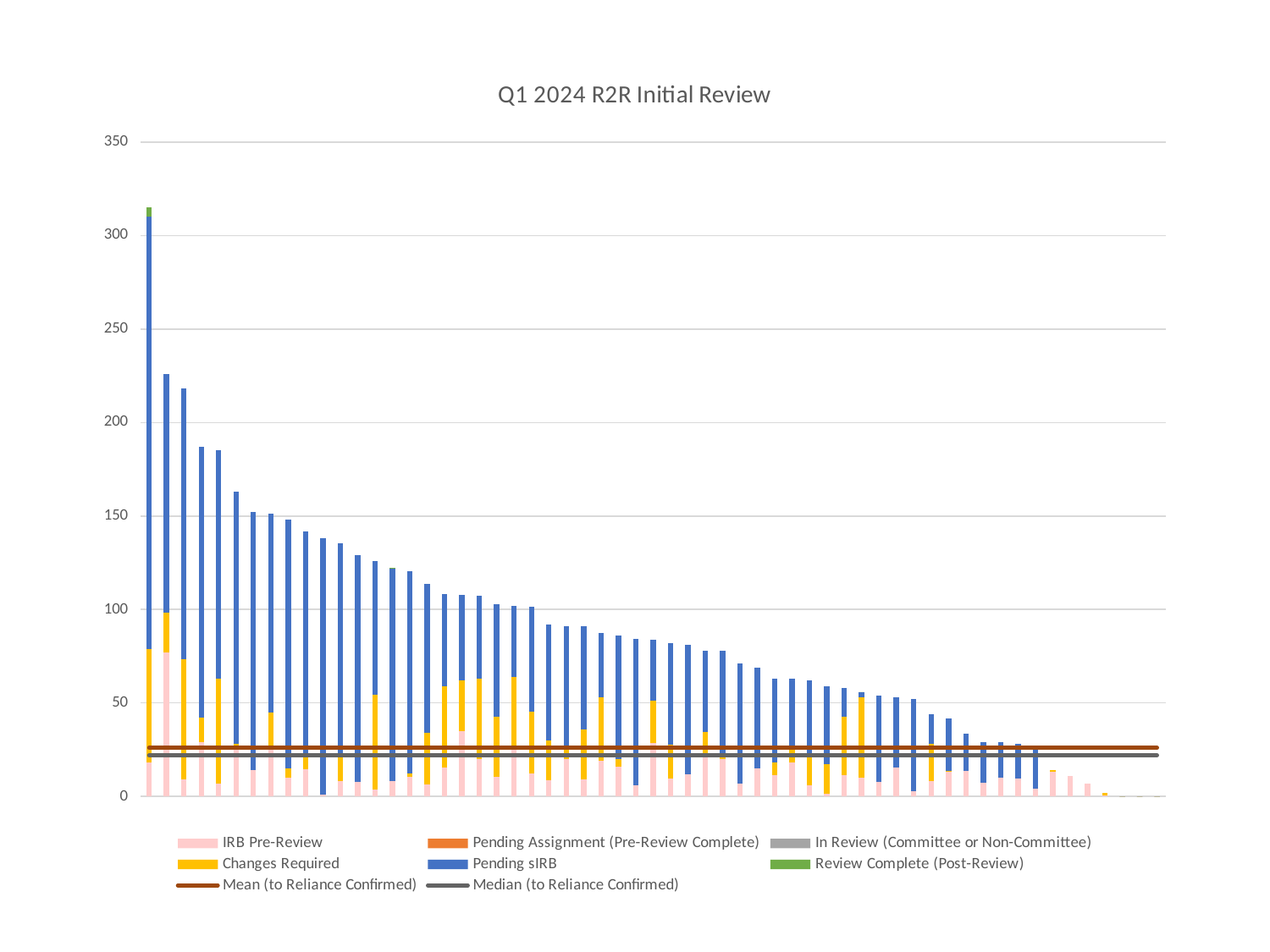
What is the title of the chart? Q1 2024 R2R Initial Review Is the value of the second-tallest bar greater or less than 250? less Which horizontal line sits higher on the chart, the Mean (to Reliance Confirmed) line or the Median (to Reliance Confirmed) line? Mean (to Reliance Confirmed) Is the value of the tallest bar greater or less than 300? greater What colour represents the Pending sIRB series in the chart? Blue What is the highest value shown on the vertical axis? 350 How many entries does the chart's legend list? 8 What kind of chart is shown on the slide? Stacked bar chart with horizontal mean and median lines (combination bar and line chart) Do the bar totals rise or fall from left to right along the x axis? fall Is the Mean (to Reliance Confirmed) line greater or less than 50? less